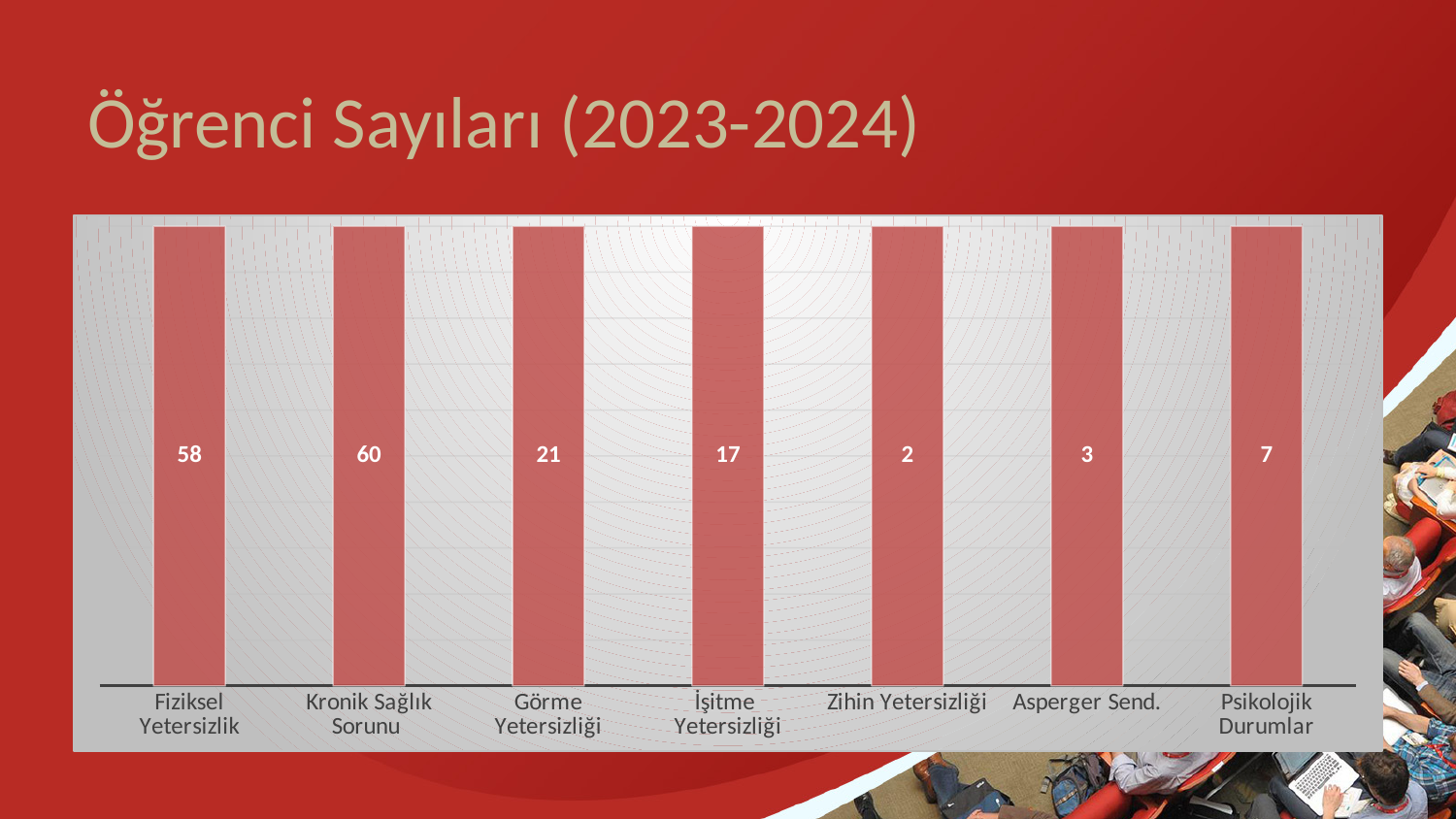
Which has a larger value, Görme Yetersizliği or İşitme Yetersizliği? Görme Yetersizliği Which category has the lowest value according to the data labels? Zihin Yetersizliği What type of chart is shown on the slide? Bar chart What is the value for Kronik Sağlık Sorunu? 60 How many categories are shown in the chart? 7 What is the value for Asperger Send.? 3 What is the value for Görme Yetersizliği? 21 What is the value for İşitme Yetersizliği? 17 What is the difference between the values for Kronik Sağlık Sorunu and Fiziksel Yetersizlik? 2 Which category has the highest value according to the data labels? Kronik Sağlık Sorunu What is the value for Psikolojik Durumlar? 7 What is the value for Fiziksel Yetersizlik? 58